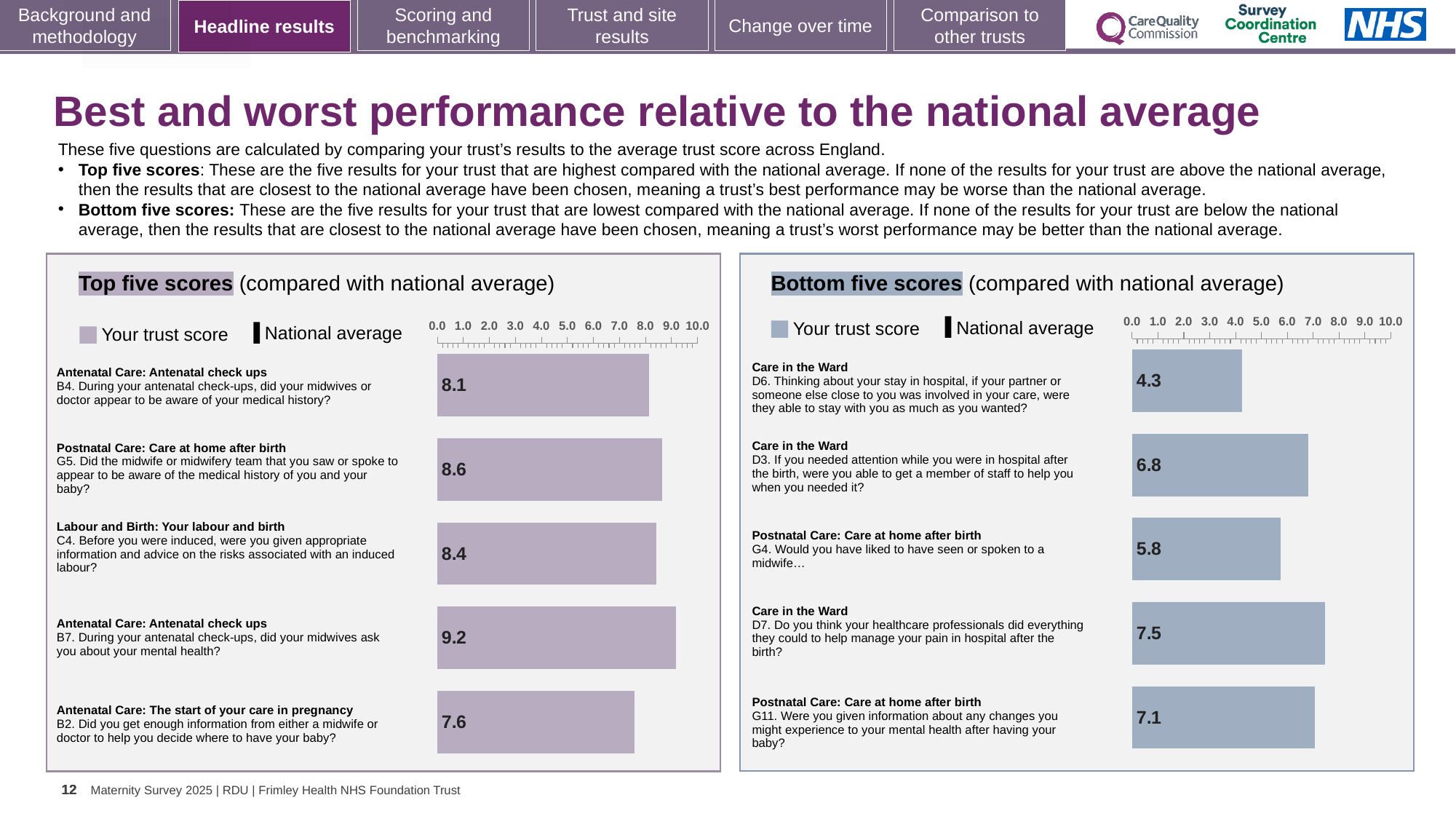
How many bars are shown on the Bottom five scores chart? 5 What type of chart is used for the Top five scores? Bar chart On the Top five scores chart, what is the trust score for B7 (did your midwives ask you about your mental health)? 9.2 On the Bottom five scores chart, which has the larger trust score, D3 or G4? D3 On the Top five scores chart, which question has the highest trust score? B7. During your antenatal check-ups, did your midwives ask you about your mental health? On the Bottom five scores chart, which question has the lowest trust score? D6. Thinking about your stay in hospital, if your partner or someone else close to you was involved in your care, were they able to stay with you as much as you wanted? On the Bottom five scores chart, what is the trust score for D6 (partner able to stay with you as much as you wanted)? 4.3 On the Bottom five scores chart, what is the difference between the trust scores for D7 and G4? 1.7 On the Top five scores chart, is the trust score for C4 greater or less than 8.0? greater On the Top five scores chart, what is the trust score for B2 (enough information to decide where to have your baby)? 7.6 On the Top five scores chart, what is the difference between the trust scores for G5 and B4? 0.5 On the Bottom five scores chart, what is the trust score for G11 (information about changes to your mental health after having your baby)? 7.1